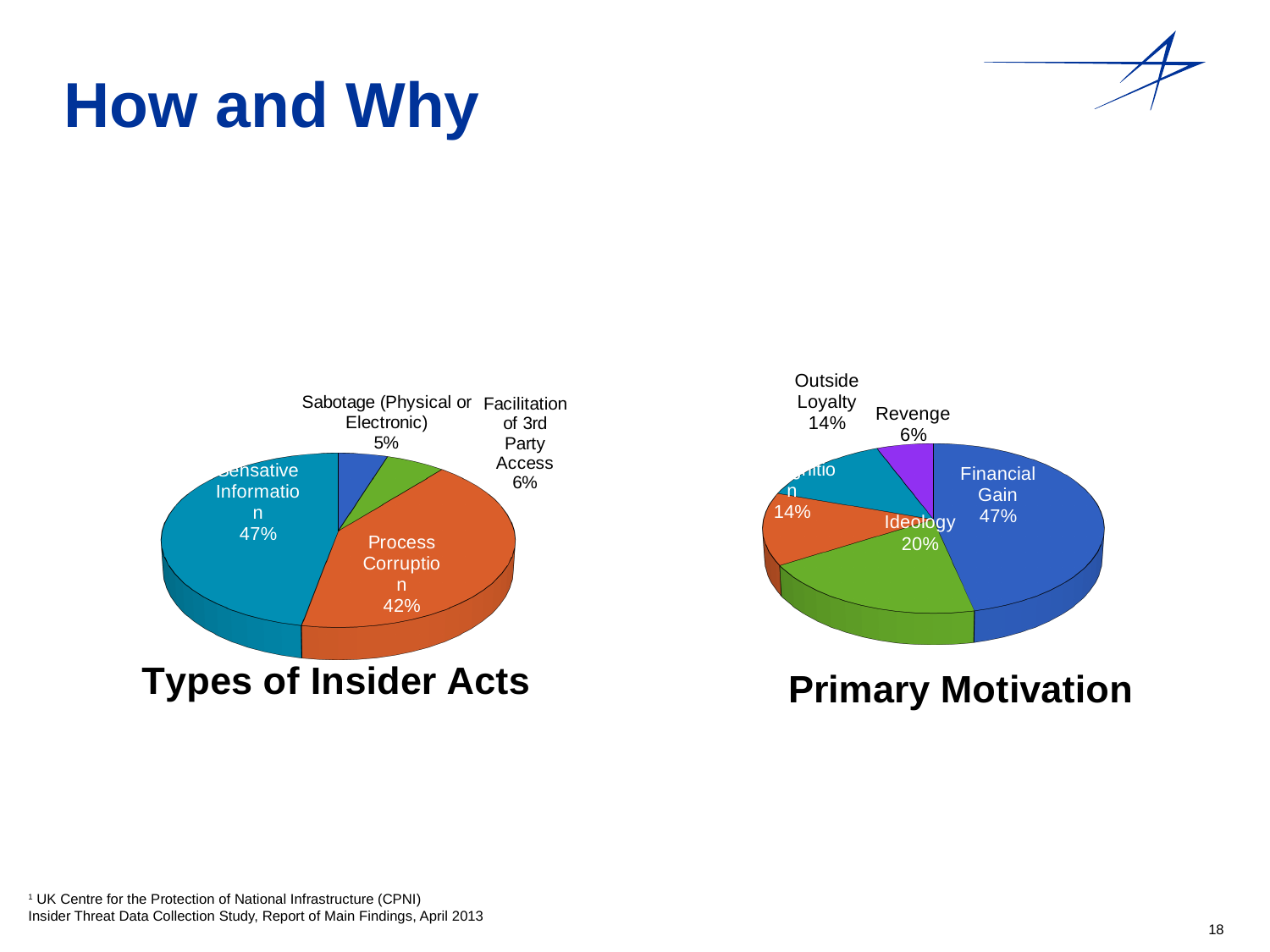
In the Primary Motivation chart, what share is Financial Gain? 47% In the Types of Insider Acts chart, what share is Process Corruption? 42% In the Types of Insider Acts chart, which category has the smallest share? Sabotage (Physical or Electronic) In the Types of Insider Acts chart, how many slices does the pie have? 4 In the Primary Motivation chart, what share is Ideology? 20% In the Primary Motivation chart, what is the difference between Financial Gain and Ideology? 27% In the Primary Motivation chart, which is larger, Outside Loyalty or Revenge? Outside Loyalty In the Primary Motivation chart, what share is Revenge? 6% In the Types of Insider Acts chart, which category has the largest share? Sensative Information What kind of chart is the Primary Motivation chart? Pie chart In the Types of Insider Acts chart, what share is Sabotage (Physical or Electronic)? 5% In the Types of Insider Acts chart, what share is Facilitation of 3rd Party Access? 6%